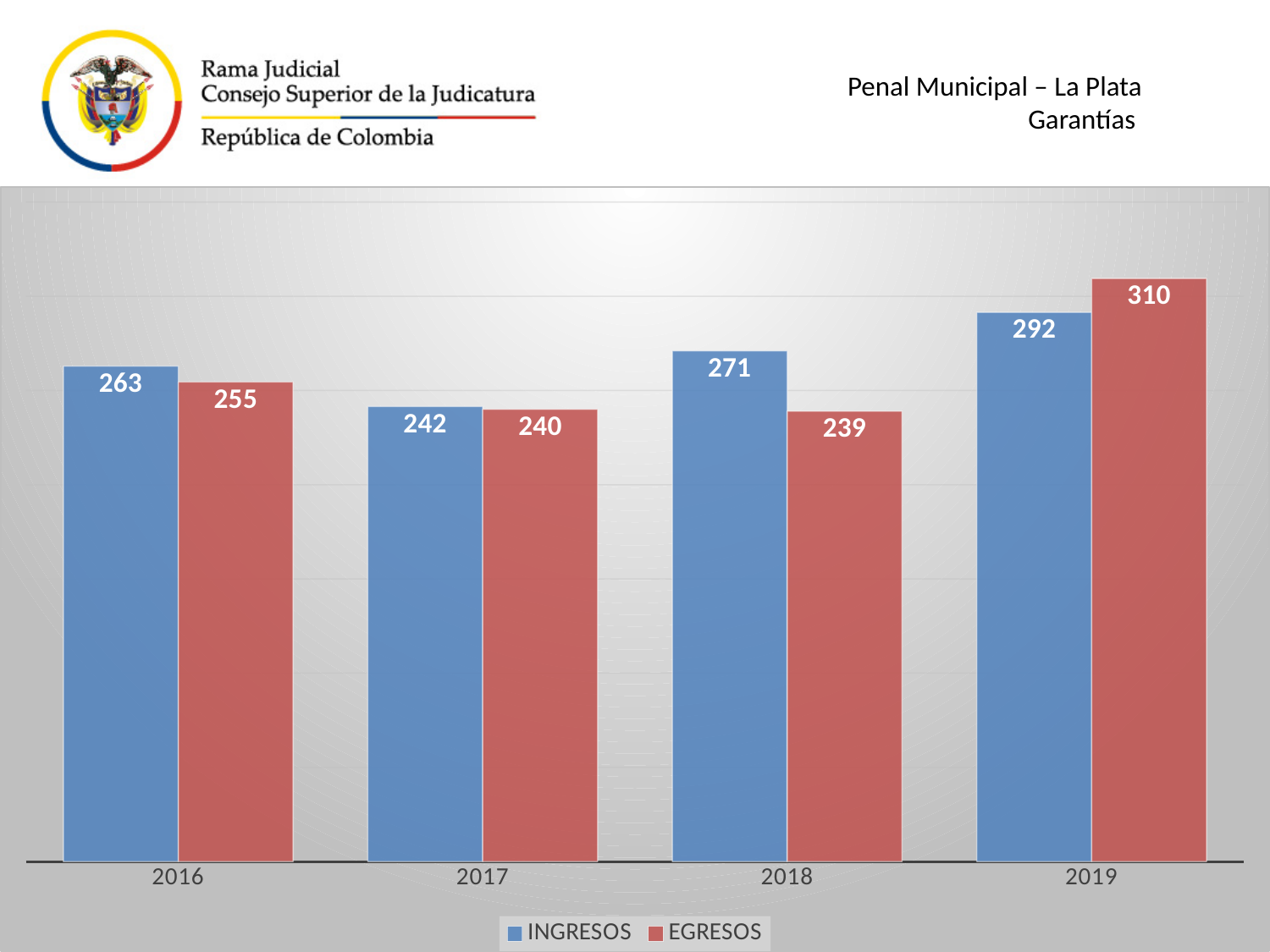
Which is larger in 2019, INGRESOS or EGRESOS? EGRESOS What is the difference between EGRESOS in 2019 and EGRESOS in 2016? 55 Which colour represents EGRESOS in the chart? Red How many series does the legend list? 2 How many years are shown on the x axis? 4 What is the EGRESOS value for 2019? 310 Which year has the lowest EGRESOS value? 2018 What kind of chart is shown on the slide? Bar chart What is the difference between INGRESOS and EGRESOS in 2018? 32 What is the INGRESOS value for 2018? 271 Which year has the highest INGRESOS value? 2019 What is the EGRESOS value for 2016? 255